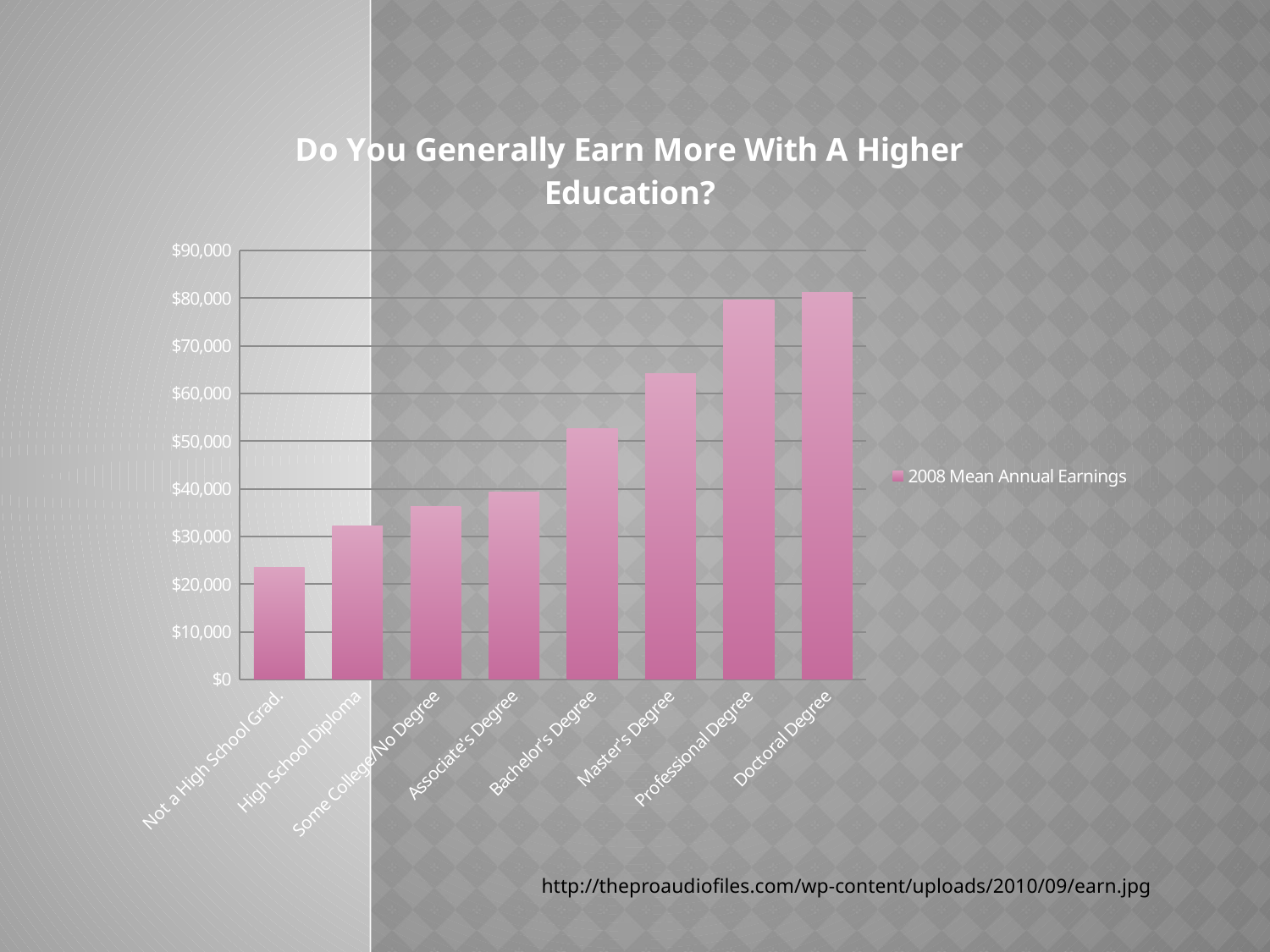
Is the value for Professional Degree greater or less than $70,000? greater How many education categories are shown on the x axis? 8 How many series does the legend list? 1 Is the value for Bachelor's Degree greater or less than $50,000? greater Which is larger, the value for Master's Degree or the value for Bachelor's Degree? Master's Degree What kind of chart is shown on the slide? bar chart Do the earnings values generally rise or fall moving from left to right along the x axis? rise Is the value for Master's Degree greater or less than $60,000? greater What series name is shown in the legend? 2008 Mean Annual Earnings What is the title of the chart? Do You Generally Earn More With A Higher Education? Which education category has the lowest mean annual earnings? Not a High School Grad.